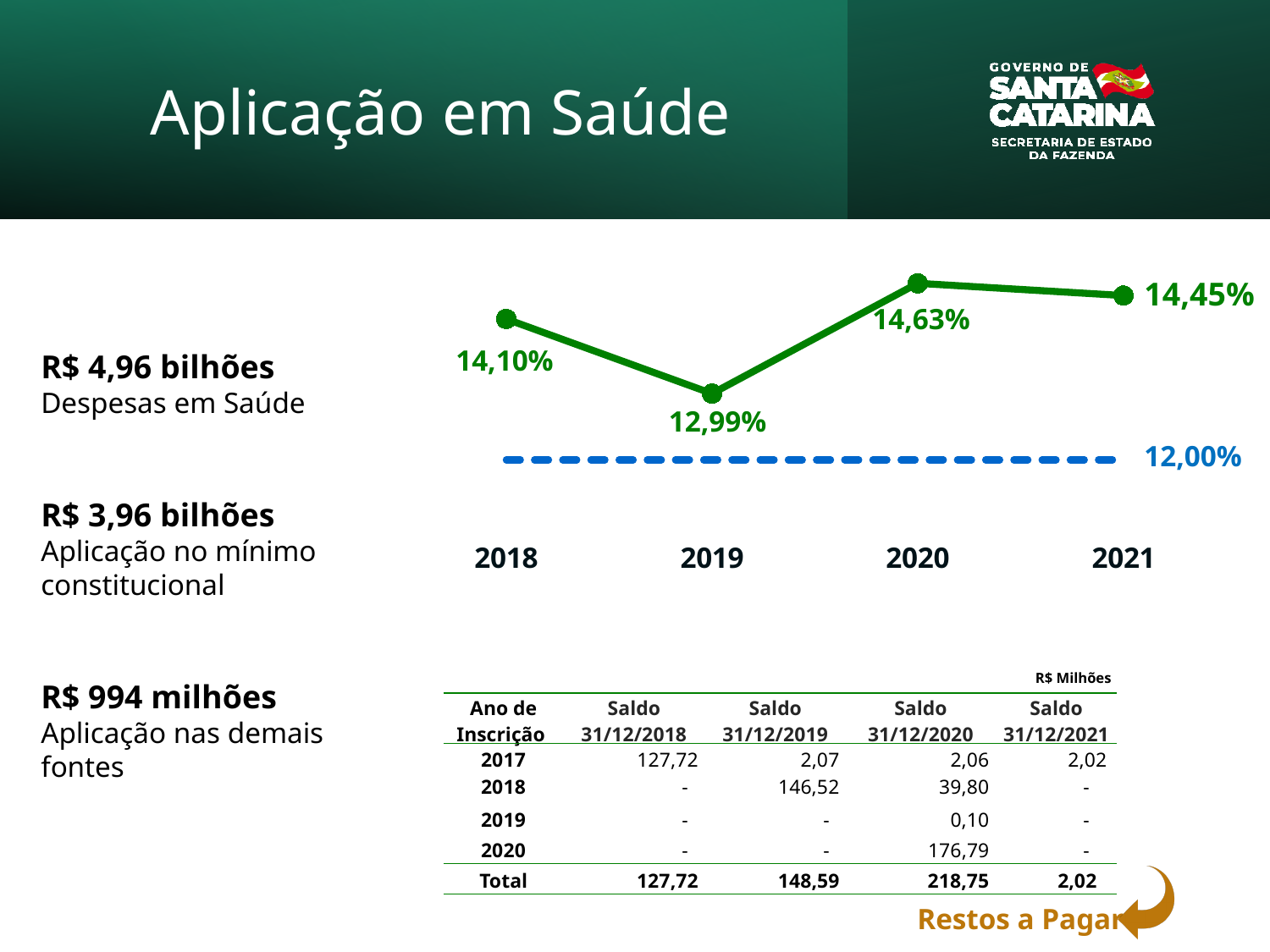
Which year has the highest value on the line chart? 2020 What is the value plotted for 2020 on the line chart? 14,63% What value does the dashed blue reference line on the chart mark? 12,00% Which year has the lowest value on the line chart? 2019 What is the value plotted for 2019 on the line chart? 12,99% What is the value plotted for 2021 on the line chart? 14,45% Which is larger on the line chart, the value for 2018 or the value for 2021? 2021 What is the difference between the 2020 value and the 2019 value on the line chart? 1,64 percentage points Does the plotted value rise or fall from 2019 to 2020 on the line chart? Rise How many years are plotted on the line chart? 4 What kind of chart is shown on the slide? Line chart What is the value plotted for 2018 on the line chart? 14,10%